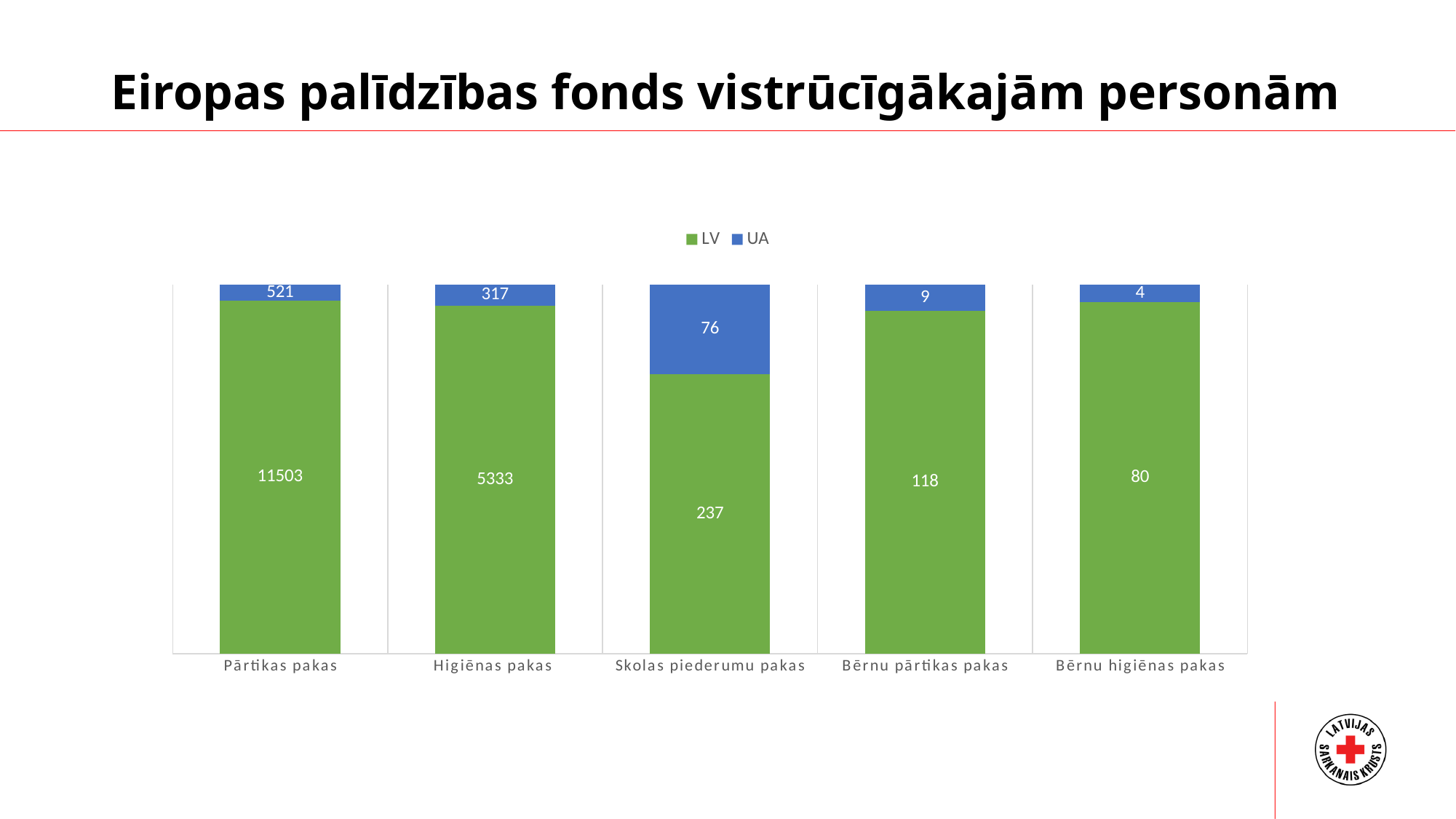
Which category has the highest LV value? Pārtikas pakas What is the UA value for Skolas piederumu pakas? 76 What is the UA value for Higiēnas pakas? 317 Which category has the lowest UA value? Bērnu higiēnas pakas How many categories are shown on the x axis? 5 Which is larger, the UA value for Pārtikas pakas or the UA value for Higiēnas pakas? Pārtikas pakas What is the LV value for Bērnu higiēnas pakas? 80 What is the difference between the LV and UA values for Skolas piederumu pakas? 161 What kind of chart is shown on the slide? Stacked bar chart What is the total of the stacked bar for Bērnu pārtikas pakas? 127 How many series does the legend list? 2 What is the LV value for Pārtikas pakas? 11503